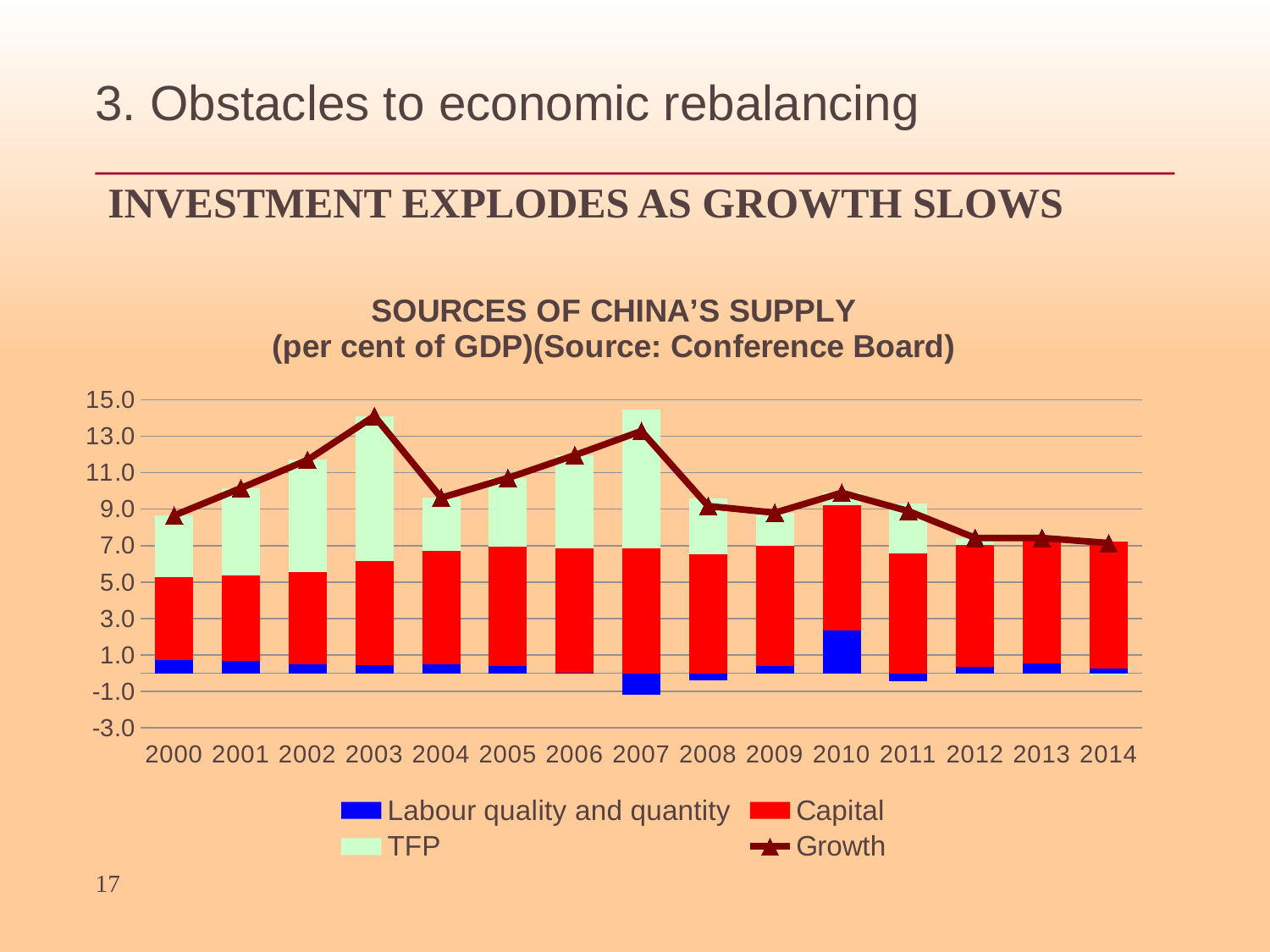
Which series is shown in blue in the chart? Labour quality and quantity Does the Growth line rise or fall from 2007 to 2014? Fall What kind of chart is shown on the slide? A stacked bar chart with a line What is the title of the chart? SOURCES OF CHINA'S SUPPLY (per cent of GDP)(Source: Conference Board) How many years are shown on the x axis of the chart? 15 Is the Labour quality and quantity value for 2010 greater or less than 1.0? greater How many series does the chart's legend list? 4 Is the Growth value for 2014 greater or less than 9.0? less Is the Growth value for 2007 greater or less than 11.0? greater In which year does the Growth line reach its highest point? 2003 Which year has a larger Growth value, 2003 or 2008? 2003